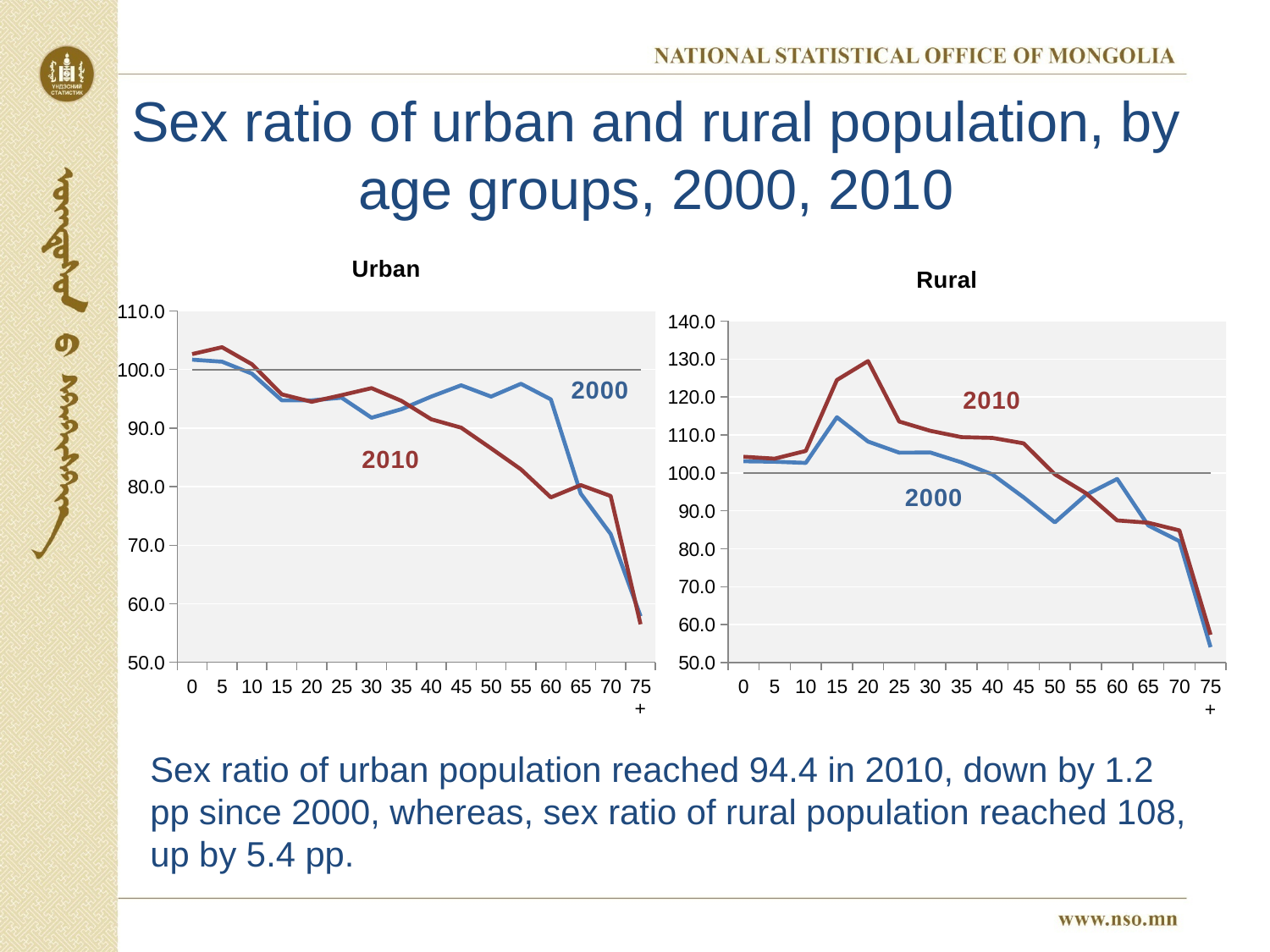
How many series are plotted on the Rural chart? 2 On the Urban chart, at age group 60, which series has the larger value, 2000 or 2010? 2000 On the Rural chart, at which age group does the 2000 line reach its highest value? 15 On the Urban chart, which colour is used for the 2010 line? red On the Urban chart, is the 2010 value for age group 75+ greater or less than 60? less On the Rural chart, does the 2010 line rise or fall from age group 20 to age group 75+? fall On the Rural chart, is the 2000 value for age group 50 greater or less than 90? less On the Rural chart, is the 2010 value for age group 20 greater or less than 120? greater How many age groups are shown along the x axis of the Urban chart? 16 On the Rural chart, at which age group does the 2010 line reach its highest value? 20 What kind of chart is the Urban chart? line chart